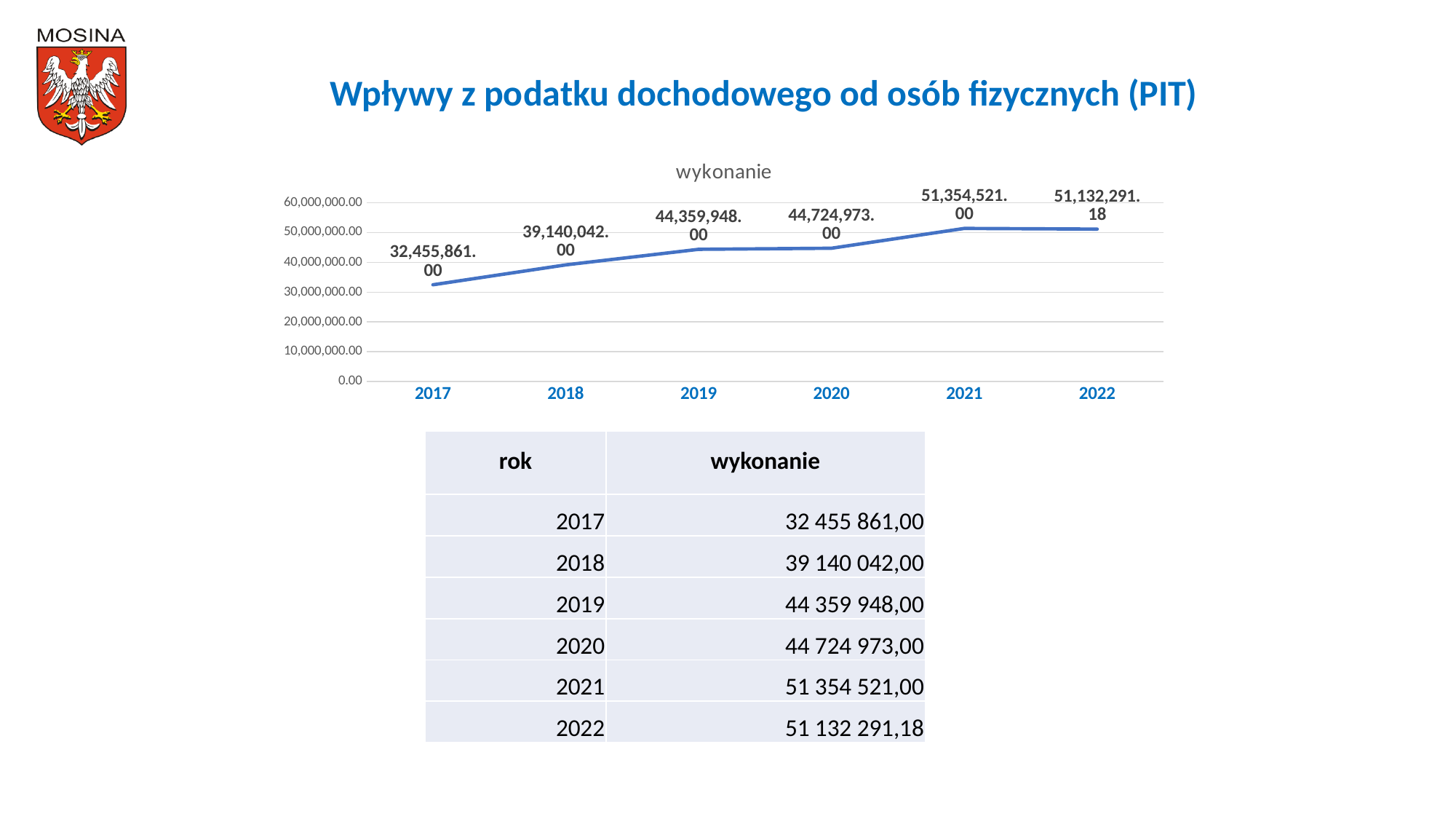
Which year has the lowest value on the chart? 2017 What is the value for 2017 on the chart? 32,455,861.00 What kind of chart is shown on the slide? line chart What is the difference between the values for 2018 and 2017? 6,684,181.00 What is the title of the chart? wykonanie Which year has the highest value on the chart? 2021 Is the value for 2017 greater or less than 30,000,000.00? greater What is the value for 2020 on the chart? 44,724,973.00 What is the difference between the values for 2021 and 2020? 6,629,548.00 What is the value for 2022 on the chart? 51,132,291.18 How many years are plotted on the chart? 6 Which is larger, the value for 2019 or the value for 2020? 2020